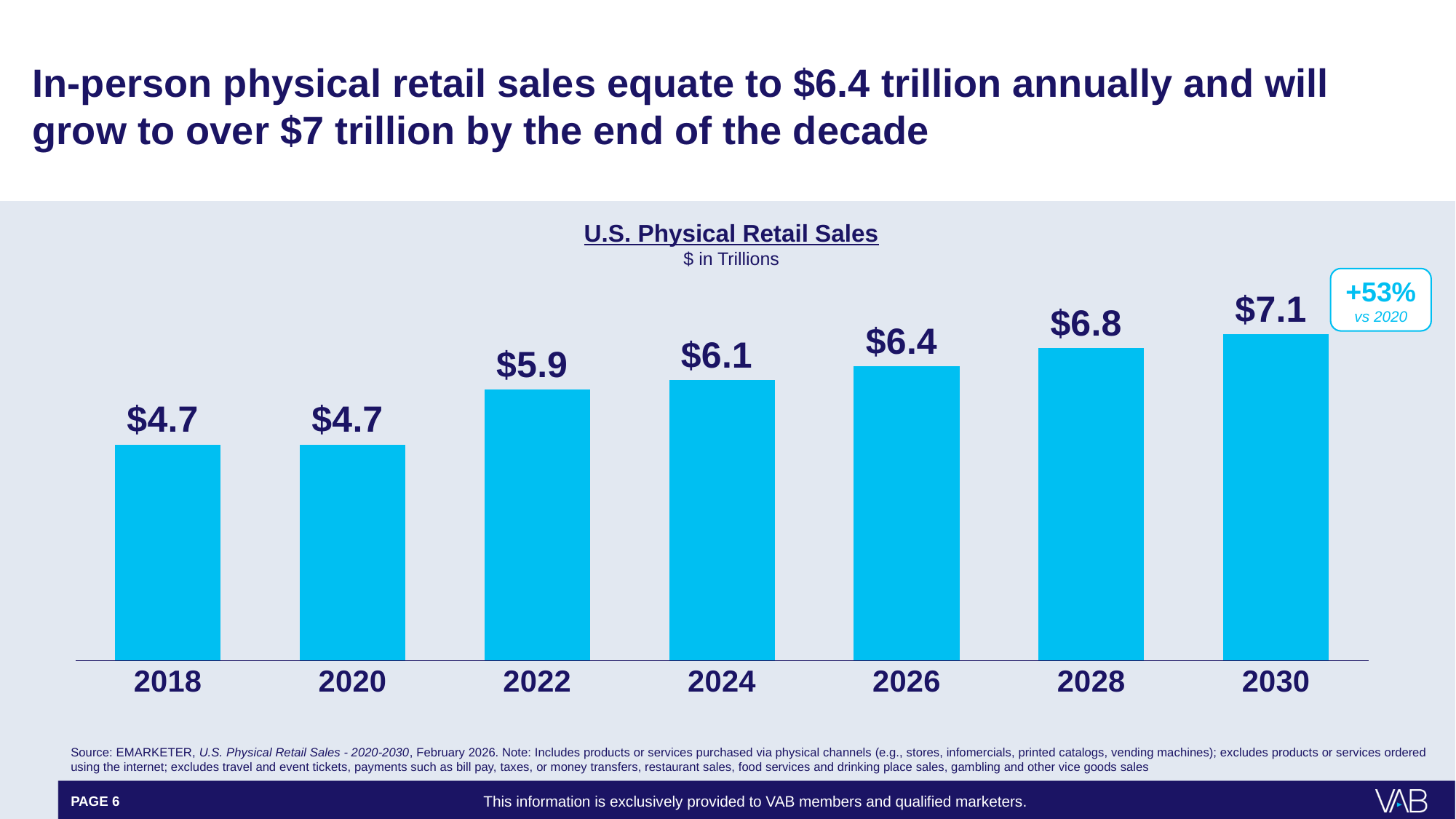
What is the value for 2030 in the U.S. Physical Retail Sales chart? $7.1 Do the values in the U.S. Physical Retail Sales chart rise or fall from 2020 to 2030? Rise What kind of chart is the U.S. Physical Retail Sales chart? Bar chart What unit is stated under the title of the U.S. Physical Retail Sales chart? $ in Trillions What is the difference between the 2028 and 2024 values in the U.S. Physical Retail Sales chart? $0.7 How many years are shown on the x axis of the U.S. Physical Retail Sales chart? 7 Which is larger in the U.S. Physical Retail Sales chart, the value for 2024 or the value for 2028? 2028 What is the value for 2022 in the U.S. Physical Retail Sales chart? $5.9 What is the difference between the 2030 and 2020 values in the U.S. Physical Retail Sales chart? $2.4 What is the value for 2026 in the U.S. Physical Retail Sales chart? $6.4 What percentage change vs 2020 is shown in the callout next to the 2030 bar? +53% Which year has the highest value in the U.S. Physical Retail Sales chart? 2030